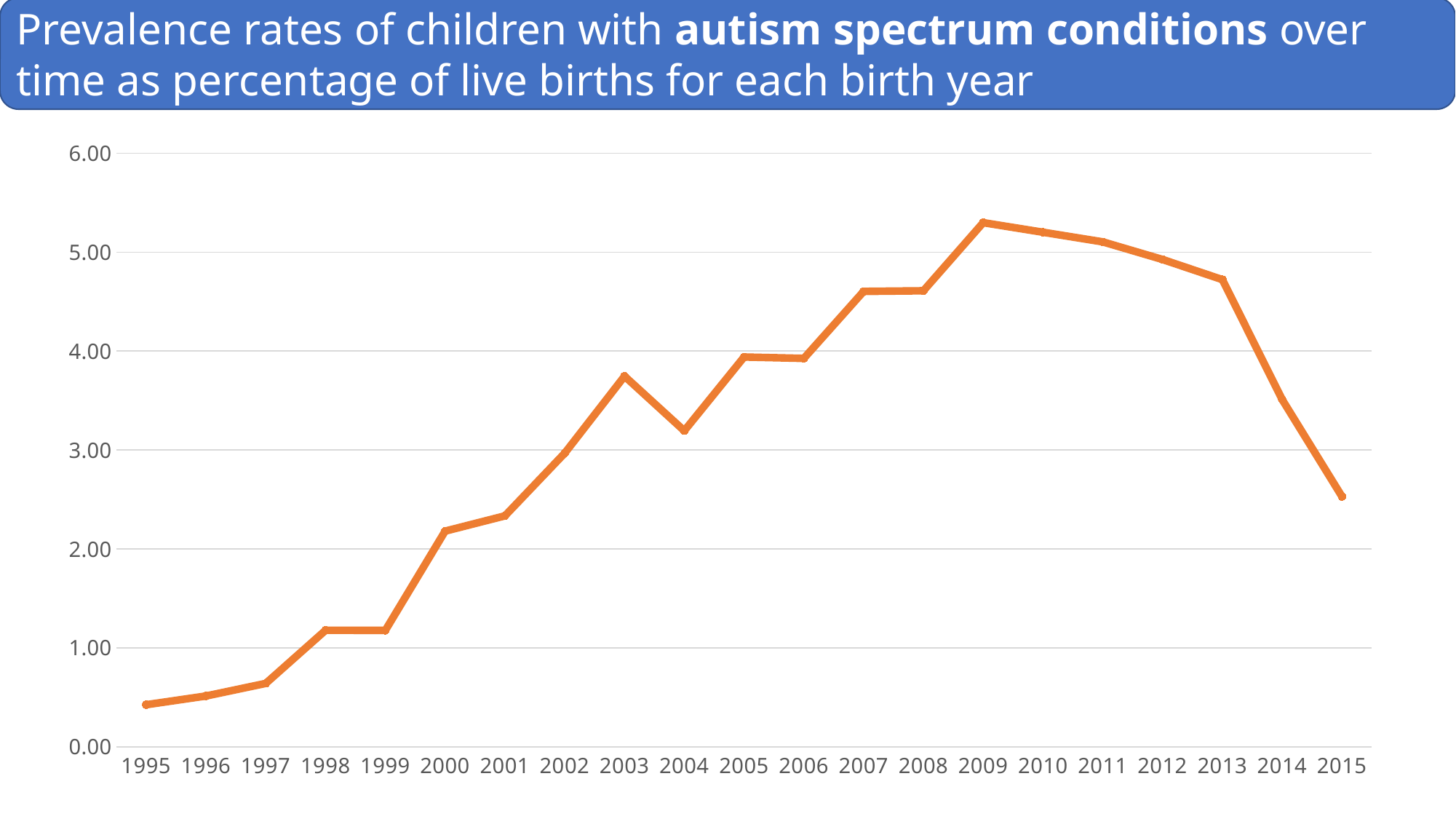
What colour is the plotted line? orange How many birth years are plotted on the x axis? 21 What kind of chart is shown on the slide? line chart Is the value for 2015 greater or less than 3.00? less Is the value for 2009 greater or less than 5.00? greater Which birth year has the highest prevalence rate? 2009 Which is larger, the value for 2003 or the value for 2004? 2003 Is the value for 2003 greater or less than 3.00? greater Do the values rise or fall from 2009 to 2015? fall Which birth year has the lowest prevalence rate? 1995